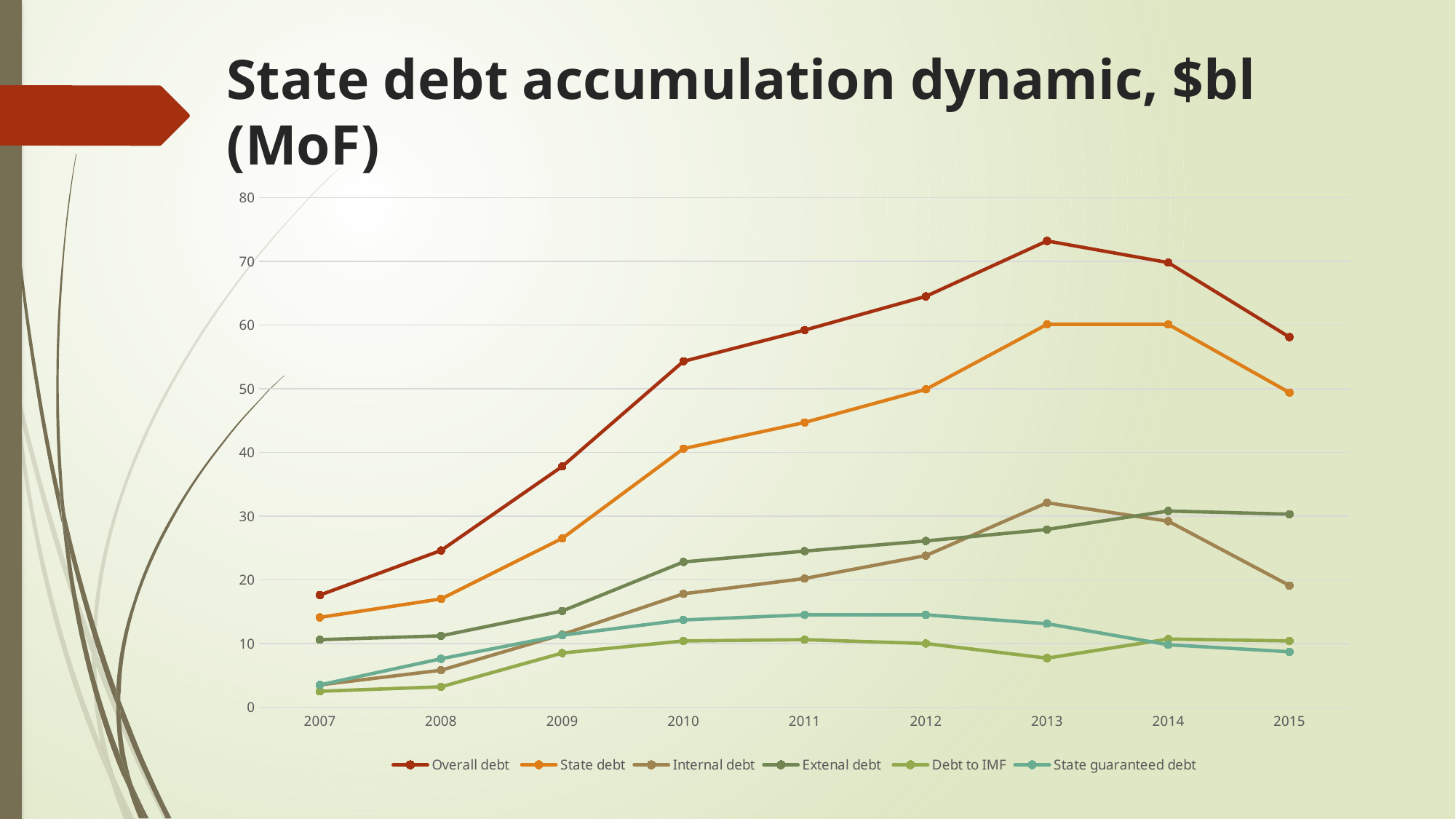
Is the value for Internal debt in 2013 greater or less than 30? greater Is the value for Overall debt in 2015 greater or less than 60? less In which year is Overall debt at its highest? 2013 What is the title of the chart? State debt accumulation dynamic, $bl (MoF) In which year is Internal debt at its highest? 2013 How many series does the legend list? 6 Is the value for Overall debt in 2013 greater or less than 70? greater Does Overall debt rise or fall from 2007 to 2013? Rise What kind of chart is shown on the slide? Line chart How many years are shown on the x axis? 9 In which year is State guaranteed debt at its lowest? 2007 Which is larger in 2015, Extenal debt or Internal debt? Extenal debt